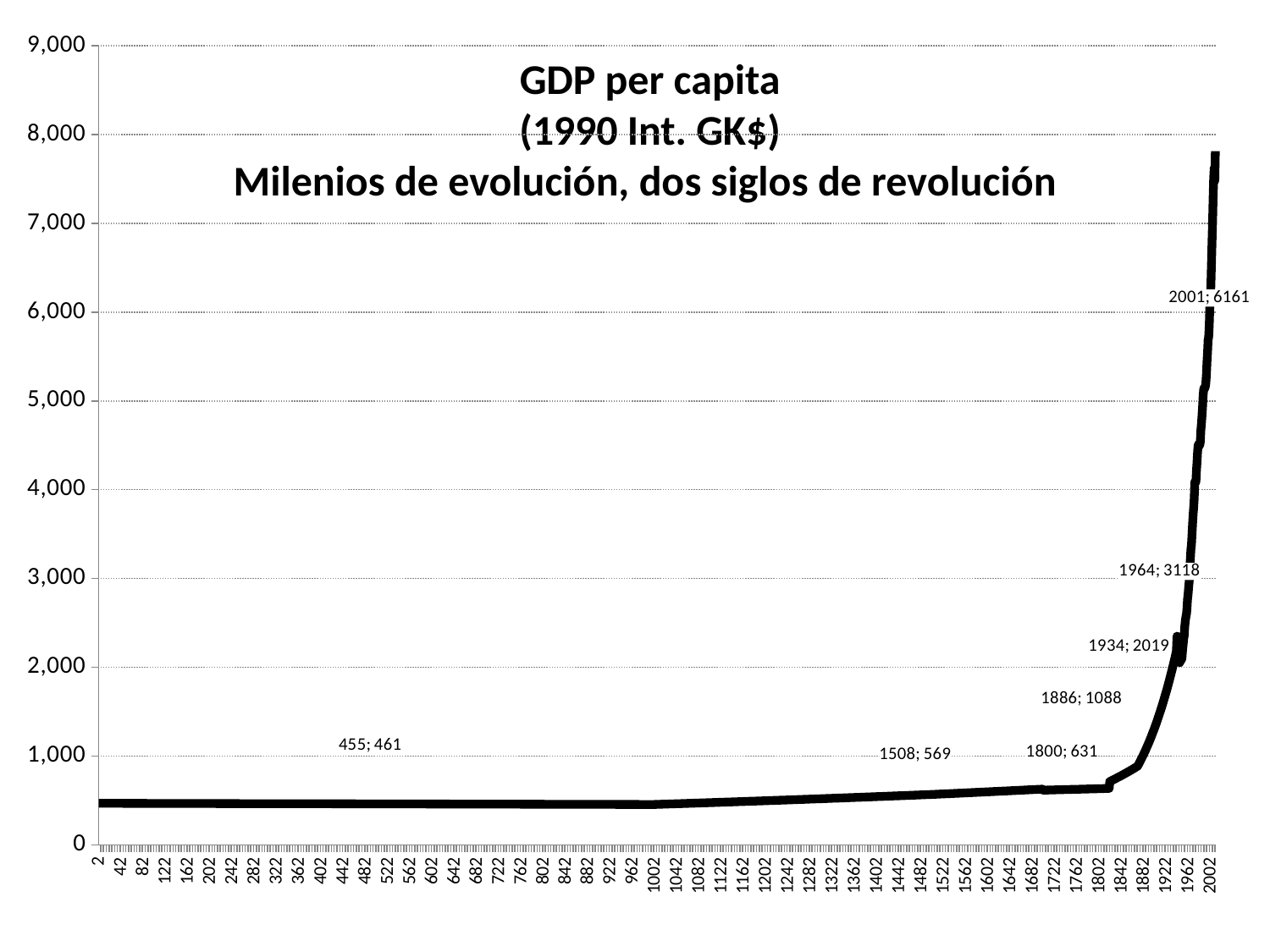
What is the GDP per capita value labelled for the year 1508? 569 Is the value at the far right end of the line (around 2002) greater or less than 7,000? greater What kind of chart is shown on the slide? line chart What is the difference between the labelled values for 1934 and 1886? 931 Do the values rise or fall along the x axis from year 2 to 2002? rise What is the difference between the labelled values for 2001 and 1964? 3043 What is the GDP per capita value labelled for the year 455? 461 What is the GDP per capita value labelled for the year 1800? 631 Which year has the larger labelled value, 1886 or 1934? 1934 What is the GDP per capita value labelled for the year 2001? 6161 What is the GDP per capita value labelled for the year 1934? 2019 Is the value for the year 1002 greater or less than 1,000? less